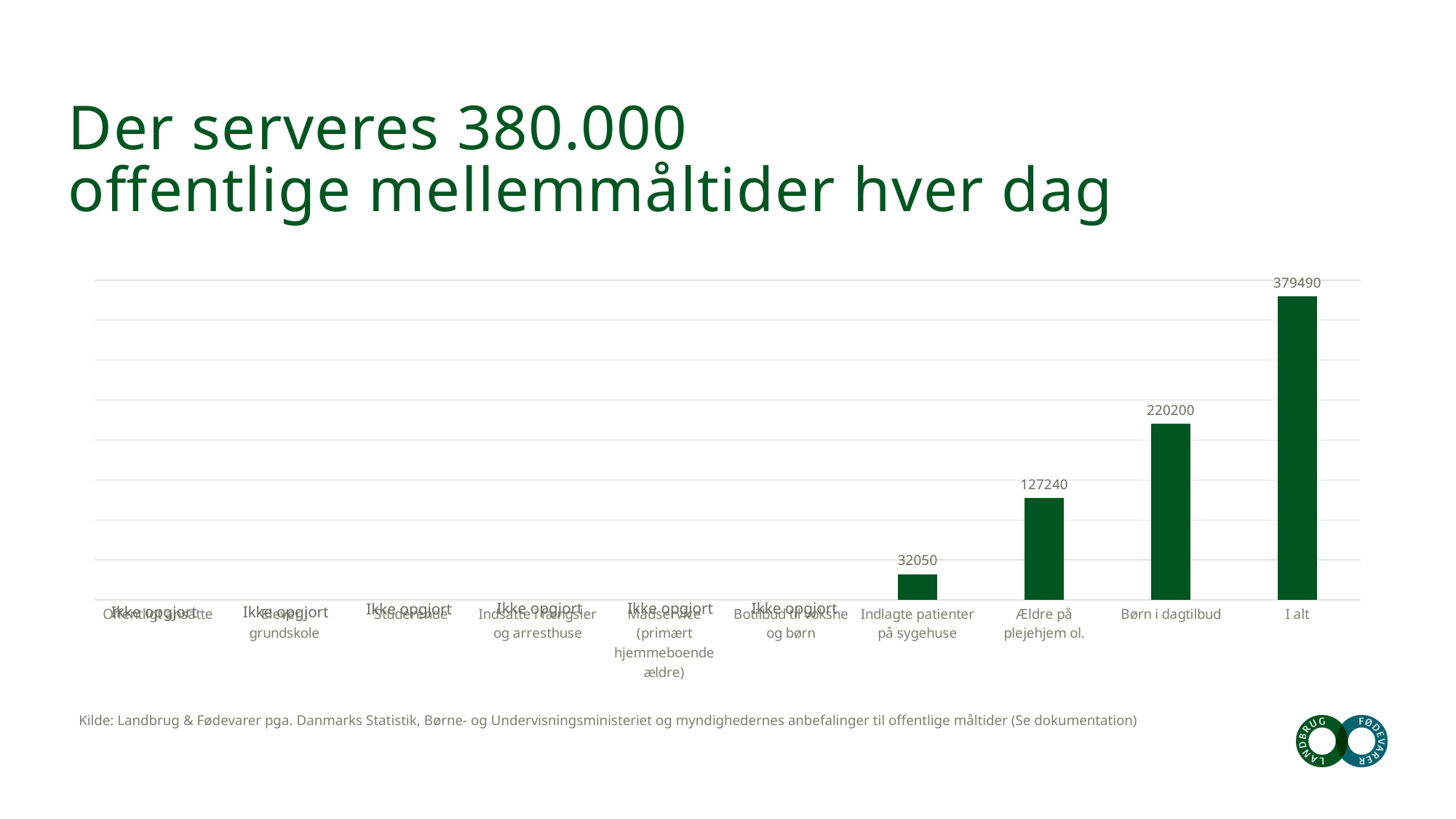
What is the value for I alt? 379490 Which is larger, the value for Børn i dagtilbud or the value for Ældre på plejehjem ol.? Børn i dagtilbud What is the value for Ældre på plejehjem ol.? 127240 What kind of chart is shown on the slide? Bar chart What is the value for Børn i dagtilbud? 220200 What is the difference between the values for Ældre på plejehjem ol. and Indlagte patienter på sygehuse? 95190 What text is shown in place of a bar for the categories without a plotted value? Ikke opgjort Among the categories with a plotted bar, which has the lowest value? Indlagte patienter på sygehuse What is the value for Indlagte patienter på sygehuse? 32050 How many categories are shown on the x axis of the chart? 10 What is the difference between the values for Børn i dagtilbud and Ældre på plejehjem ol.? 92960 Which category has the highest value? I alt